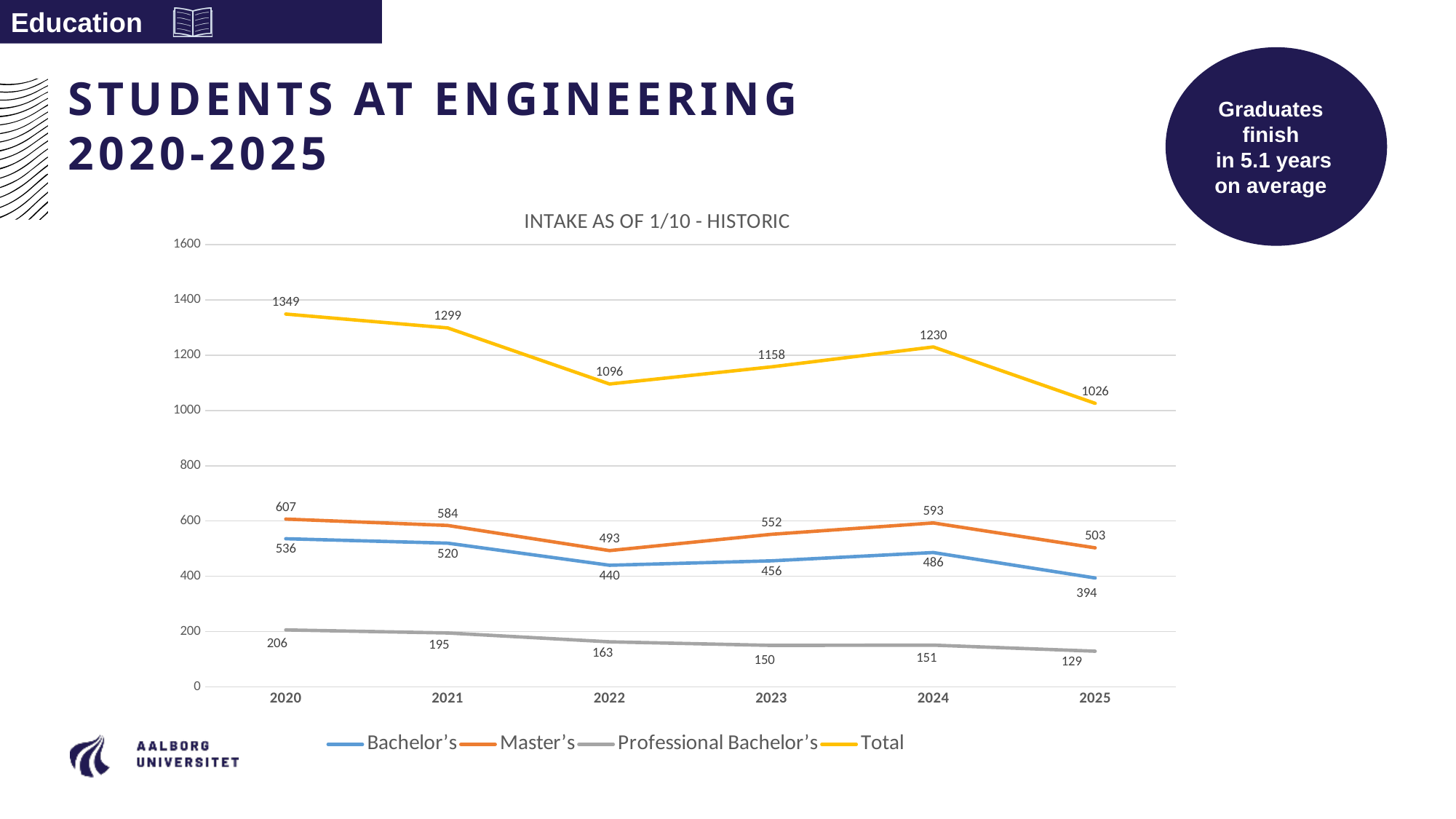
What is the Professional Bachelor's intake value for 2025? 129 How many years are shown on the x axis? 6 What is the title of the chart? INTAKE AS OF 1/10 - HISTORIC How many series does the legend list? 4 In which year is the Total intake lowest? 2025 What is the Total intake value for 2020? 1349 Which is larger, the Master's intake in 2024 or the Master's intake in 2021? Master's intake in 2024 What kind of chart is shown on the slide? Line chart In which year is the Bachelor's intake highest? 2020 What is the Master's intake value for 2023? 552 What is the difference between the Total intake in 2020 and in 2025? 323 Does the Professional Bachelor's intake rise or fall from 2020 to 2025? Fall